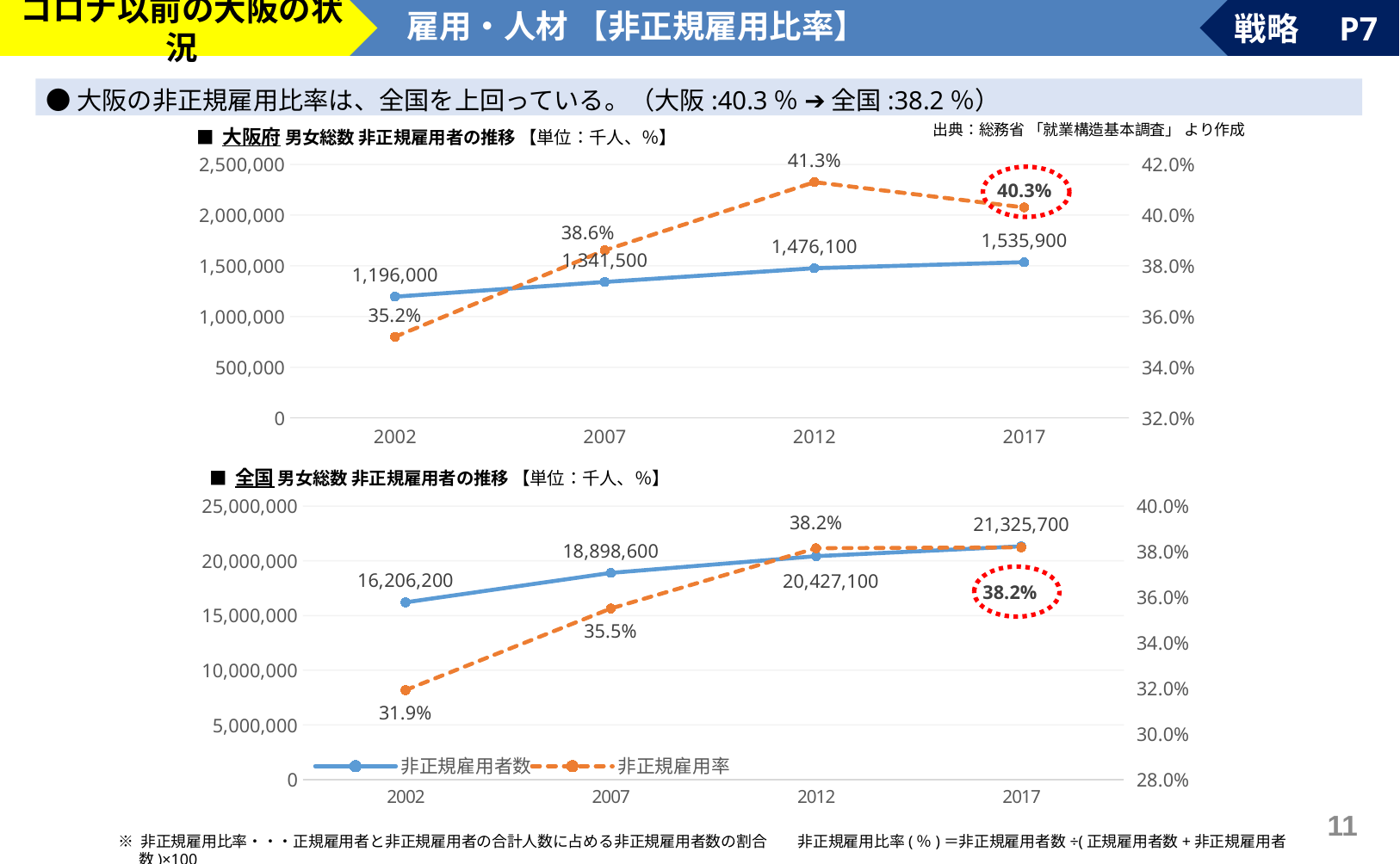
In the top chart (大阪府), what is the non-regular employment rate (非正規雇用率) in 2002? 35.2% In the bottom chart (全国), in which year is the number of non-regular employees lowest? 2002 In the bottom chart (全国), what is the non-regular employment rate in 2002? 31.9% In the top chart (大阪府), by how much did the number of non-regular employees increase from 2002 to 2017? 339,900 Which is larger: the 2017 non-regular employment rate in the top chart (大阪府) or in the bottom chart (全国)? 大阪府 (40.3%) In the top chart (大阪府), what is the number of non-regular employees (非正規雇用者数) in 2017? 1,535,900 In the bottom chart (全国), what is the number of non-regular employees in 2007? 18,898,600 What type of chart is the bottom chart (全国)? Line chart How many years are plotted on the x axis of the top chart (大阪府)? 4 In the bottom chart (全国), what is the difference in the non-regular employment rate between 2002 and 2007? 3.6% In the top chart (大阪府), in which year is the non-regular employment rate highest? 2012 How many series does the legend of the bottom chart (全国) list? 2